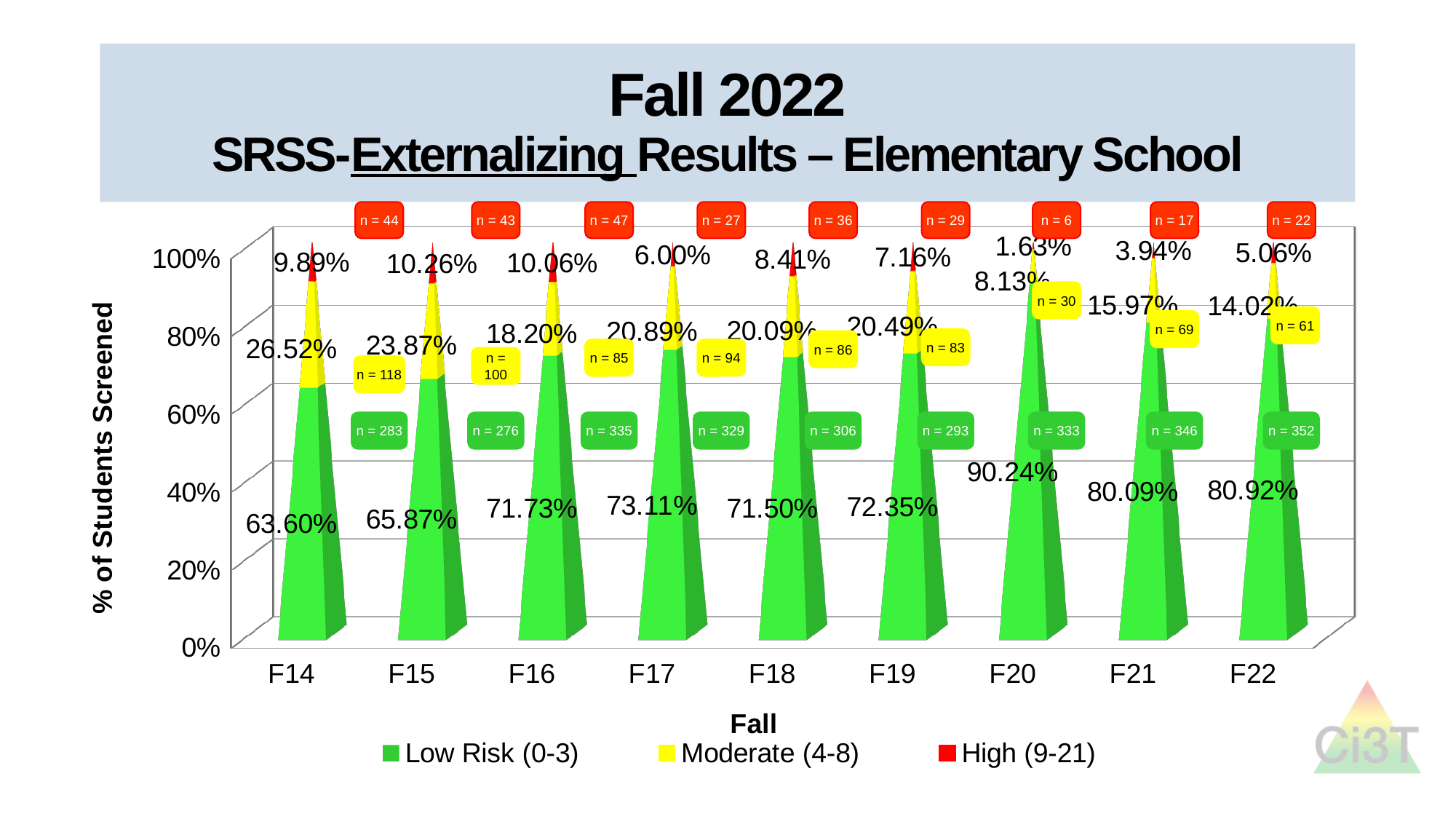
What is the High (9-21) percentage for F17? 6.00% How many series does the legend list? 3 How many fall screening periods are shown on the x axis? 9 What kind of chart is shown on the slide? Stacked bar chart Which is larger, the Moderate (4-8) percentage for F14 or for F16? F14 Which fall has the lowest High (9-21) percentage? F20 What is the Moderate (4-8) percentage for F21? 15.97% How many students were in the Low Risk (0-3) group in F22 (the n value)? n = 352 What is the Low Risk (0-3) percentage for F14? 63.60% What is the main title of the slide? Fall 2022 Which fall has the highest Low Risk (0-3) percentage? F20 What is the difference between the Low Risk (0-3) percentage in F22 and in F14? 17.32%